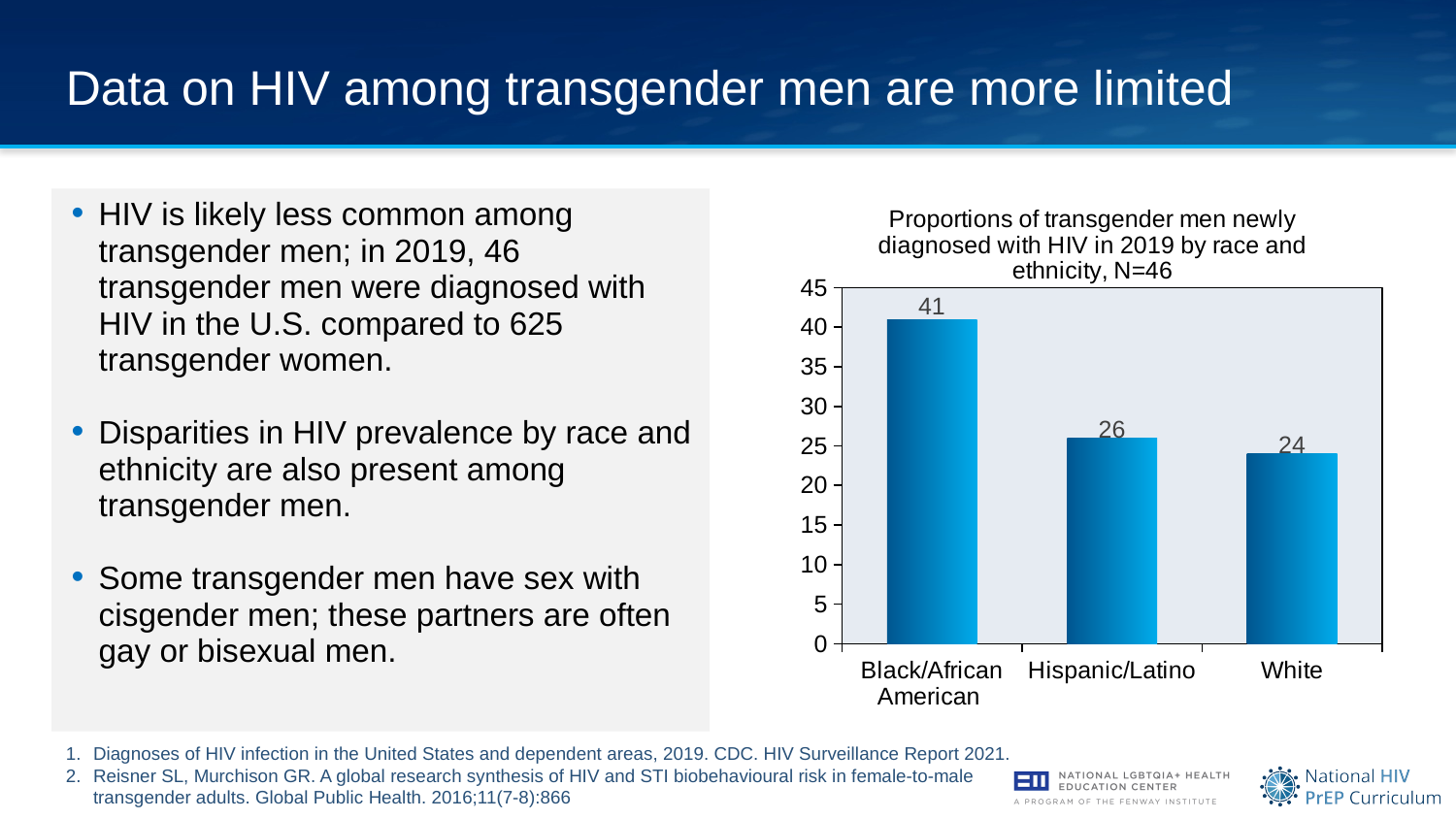
What is the title of the chart? Proportions of transgender men newly diagnosed with HIV in 2019 by race and ethnicity, N=46 Which category has the highest value in the chart? Black/African American What is the difference between the values for Hispanic/Latino and White? 2 Is the value for Black/African American greater or less than 40? greater What kind of chart is shown on the slide? Bar chart What is the value for Black/African American in the chart? 41 Which is larger, the value for Black/African American or the value for White? Black/African American What is the value for Hispanic/Latino in the chart? 26 Which category has the lowest value in the chart? White What is the difference between the values for Black/African American and Hispanic/Latino? 15 What is the value for White in the chart? 24 How many categories are shown in the chart? 3